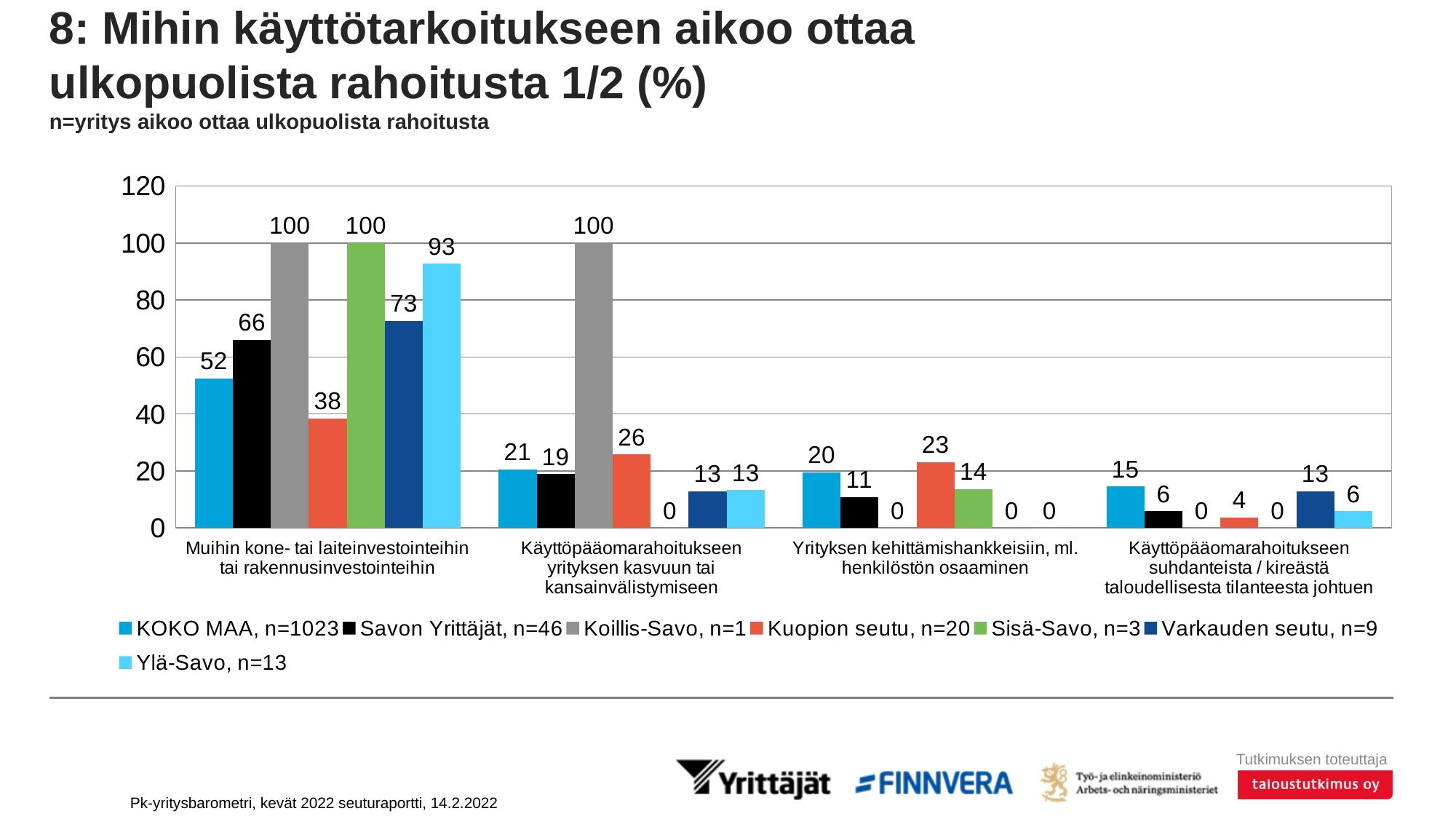
What is the value for KOKO MAA in the category 'Muihin kone- tai laiteinvestointeihin tai rakennusinvestointeihin'? 52 In the category 'Yrityksen kehittämishankkeisiin, ml. henkilöstön osaaminen', which series has the highest value? Kuopion seutu, n=20 How many series does the legend list? 7 What is the difference between the Savon Yrittäjät value and the KOKO MAA value in the category 'Muihin kone- tai laiteinvestointeihin tai rakennusinvestointeihin'? 14 In the category 'Käyttöpääomarahoitukseen yrityksen kasvuun tai kansainvälistymiseen', which is larger: the KOKO MAA value or the Savon Yrittäjät value? KOKO MAA Does the KOKO MAA value rise or fall from the first category to the last category along the x axis? Fall In the category 'Muihin kone- tai laiteinvestointeihin tai rakennusinvestointeihin', which series has the lowest value? Kuopion seutu, n=20 What is the value for Kuopion seutu in the category 'Käyttöpääomarahoitukseen yrityksen kasvuun tai kansainvälistymiseen'? 26 What is the value for Varkauden seutu in the category 'Käyttöpääomarahoitukseen suhdanteista / kireästä taloudellisesta tilanteesta johtuen'? 13 How many categories are shown on the x axis of the chart? 4 What kind of chart is shown on the slide? Bar chart What is the value for Ylä-Savo in the category 'Muihin kone- tai laiteinvestointeihin tai rakennusinvestointeihin'? 93